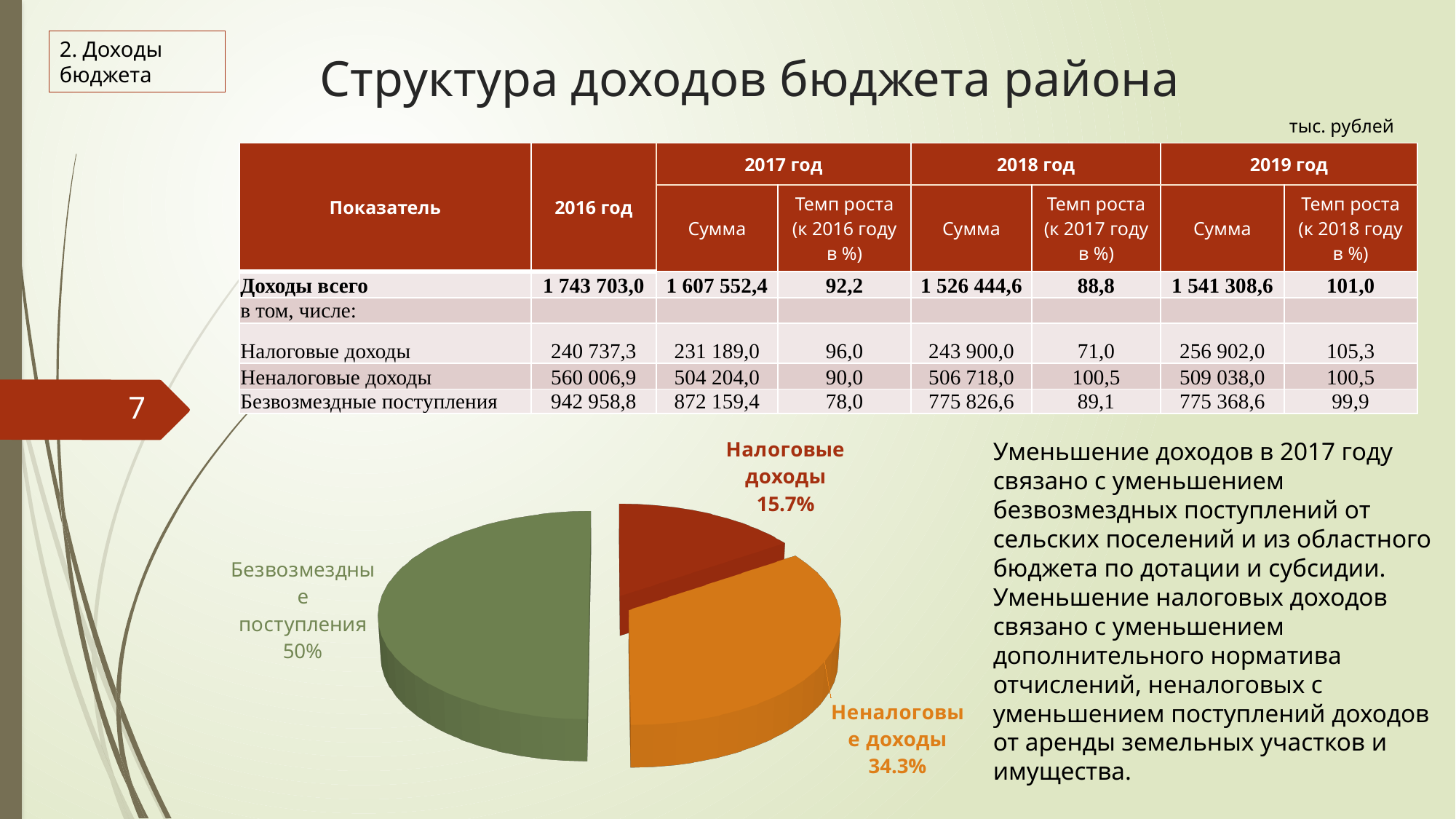
What is the difference in percentage points between the Неналоговые доходы slice and the Налоговые доходы slice? 18.6 What is the difference in percentage points between the Безвозмездные поступления slice and the Неналоговые доходы slice? 15.7 What share of the pie chart is labelled Безвозмездные поступления? 50% What colour is the Неналоговые доходы slice in the pie chart? orange How many slices does the pie chart have? 3 Which slice of the pie chart is the smallest? Налоговые доходы Which slice of the pie chart is the largest? Безвозмездные поступления Which is larger in the pie chart: Неналоговые доходы or Налоговые доходы? Неналоговые доходы What share of the pie chart is labelled Налоговые доходы? 15.7% What kind of chart is shown on the slide? pie chart What share of the pie chart is labelled Неналоговые доходы? 34.3% What colour is the Безвозмездные поступления slice in the pie chart? green